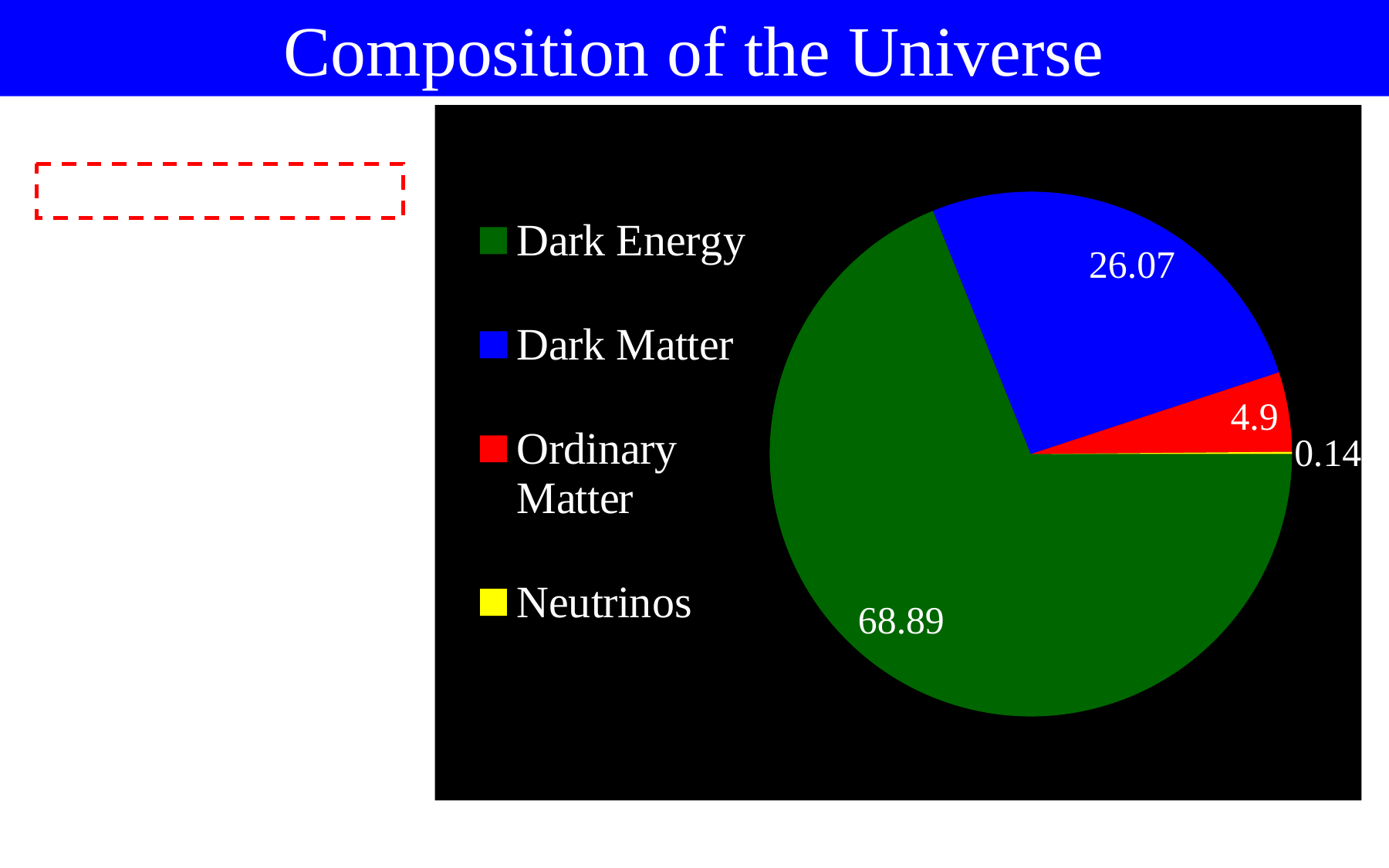
What is the value for Ordinary Matter? 4.9 Which category has the smallest slice? Neutrinos What is the title of the slide? Composition of the Universe What is the value for Dark Matter? 26.07 How many categories does the pie chart show? 4 Which is larger, Dark Matter or Ordinary Matter? Dark Matter What is the value for Dark Energy? 68.89 What is the value for Neutrinos? 0.14 What colour represents Neutrinos in the legend? yellow Which category has the largest slice? Dark Energy What is the difference between the values for Dark Energy and Dark Matter? 42.82 What type of chart is shown on the slide? pie chart